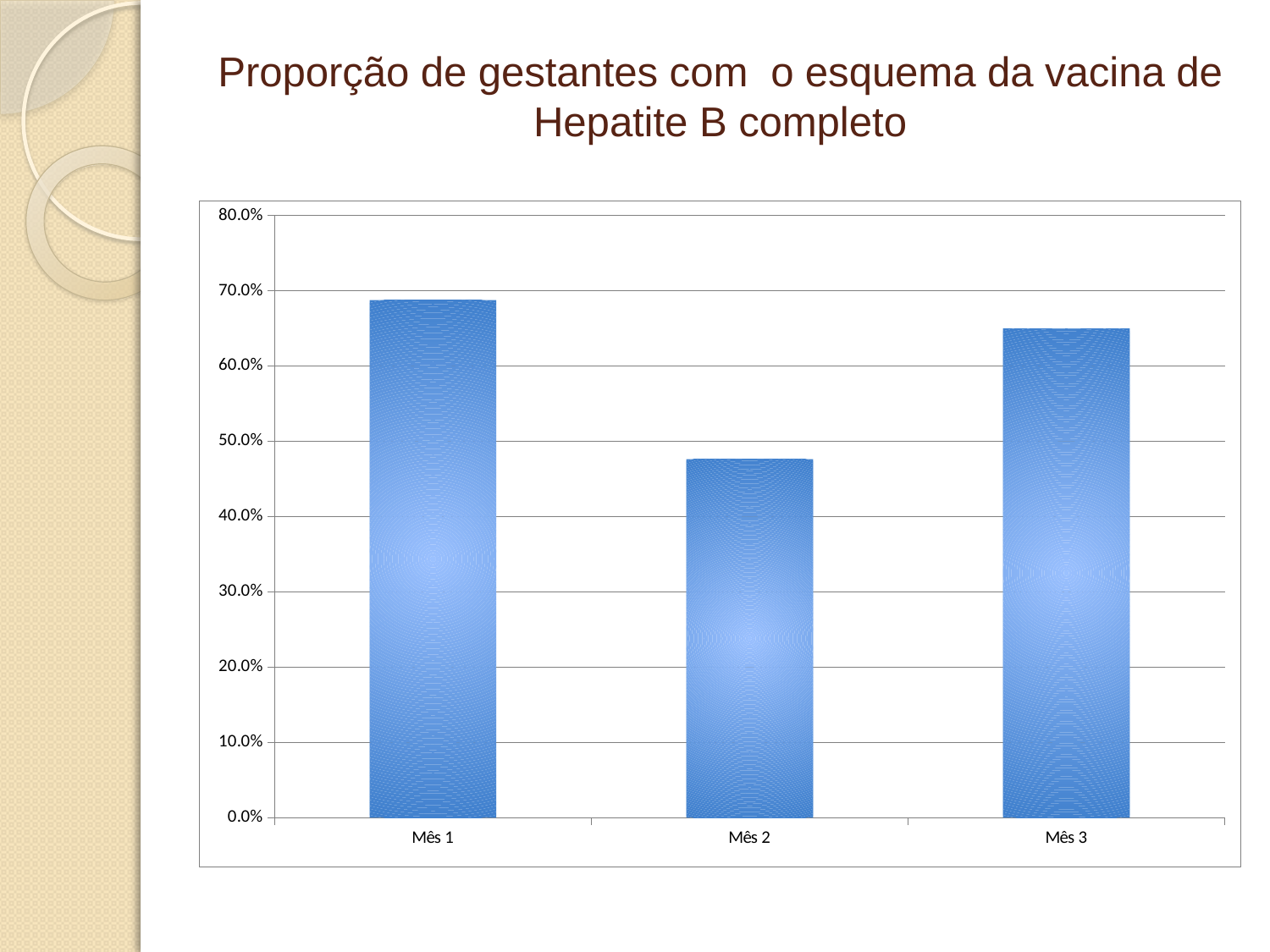
Which month has the lowest value in the chart? Mês 2 Is the value for Mês 2 greater or less than 50.0%? less How many categories are shown on the x axis of the chart? 3 What is the title of the slide containing the chart? Proporção de gestantes com o esquema da vacina de Hepatite B completo Is the value for Mês 3 greater or less than 70.0%? less Which is larger, the value for Mês 1 or the value for Mês 2? Mês 1 Which is larger, the value for Mês 2 or the value for Mês 3? Mês 3 Is the value for Mês 2 greater or less than 40.0%? greater What kind of chart is shown on the slide? bar chart Which month has the highest value in the chart? Mês 1 Does the value rise or fall from Mês 1 to Mês 2? fall